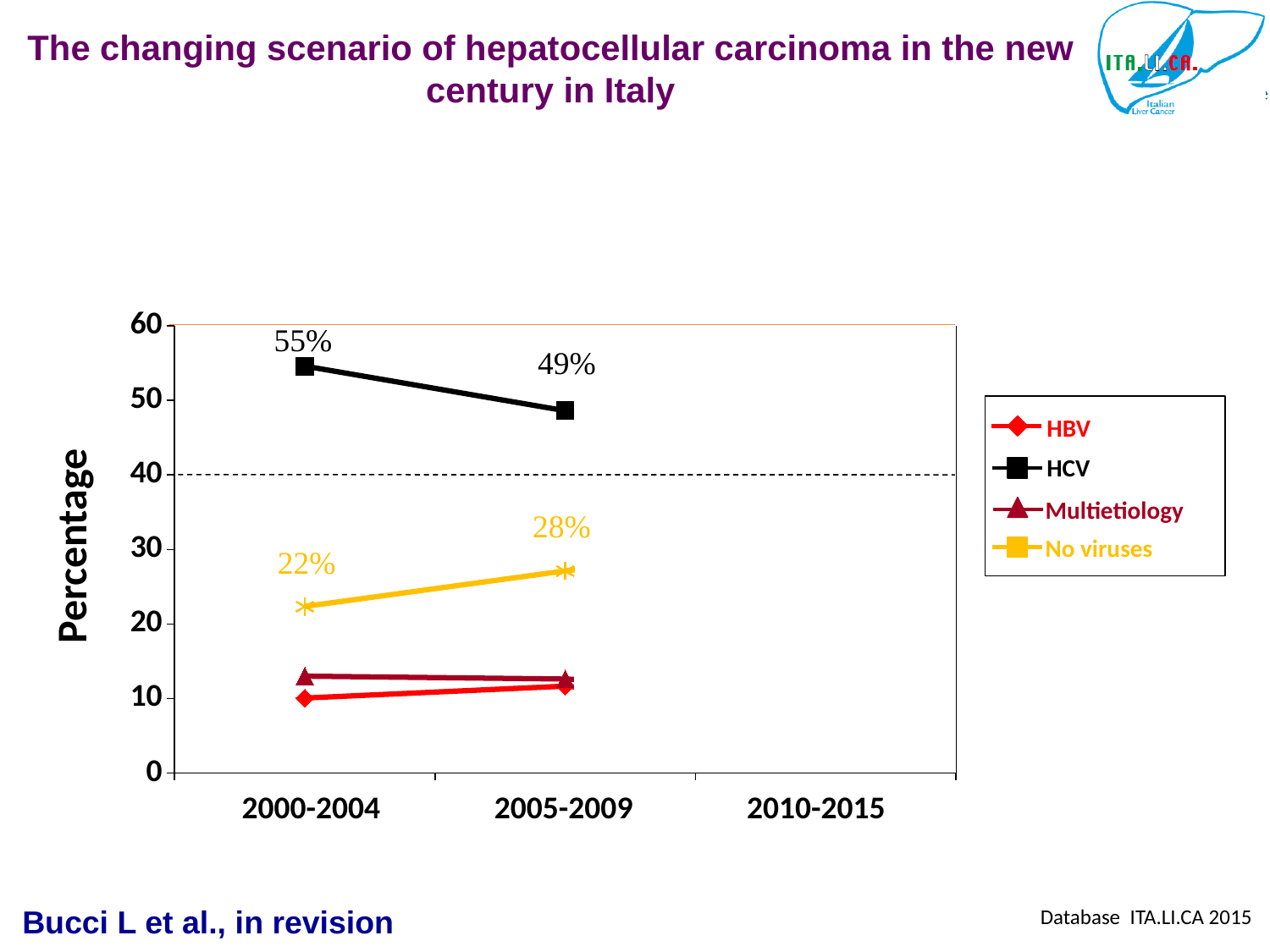
What is the value for HCV in 2005-2009? 49% By how much did the HCV value fall from 2000-2004 to 2005-2009? 6% What is the value for No viruses in 2005-2009? 28% How many series does the legend list? 4 What kind of chart is shown on the slide? line chart What is the value for No viruses in 2000-2004? 22% Which series has the lowest value in 2000-2004? HBV What is the title of the vertical axis? Percentage Does the HCV value rise or fall from 2000-2004 to 2005-2009? fall Which series has the highest value in 2000-2004? HCV What is the value for HCV in 2000-2004? 55% Is the value for HBV in 2000-2004 greater or less than 20? less